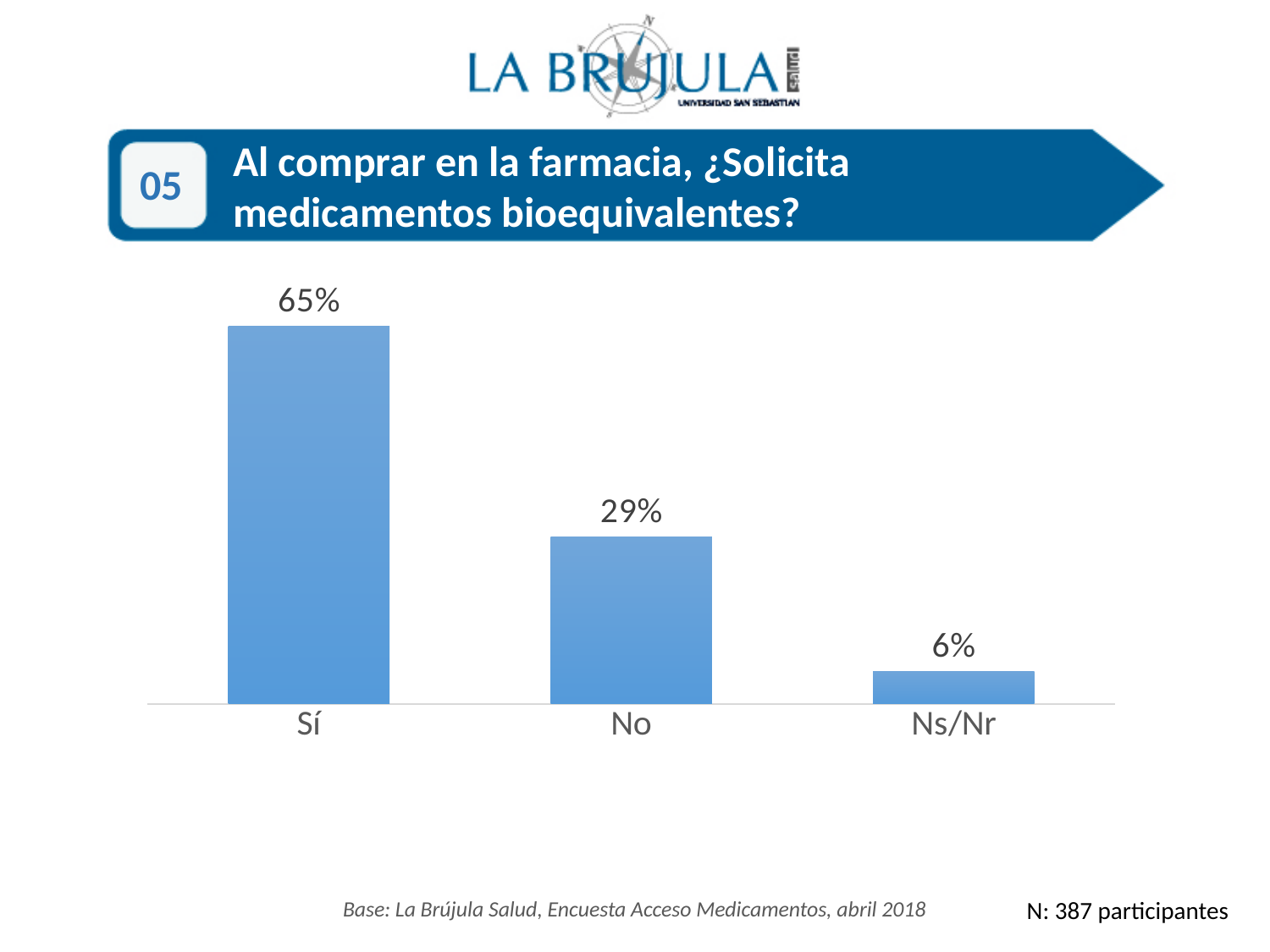
What is the value for Sí? 65% What kind of chart is shown on the slide? Bar chart What is the value for Ns/Nr? 6% Which category has the lowest value? Ns/Nr Do the values rise or fall from left to right along the x axis? Fall Which is larger, the value for No or the value for Ns/Nr? No What is the value for No? 29% What is the difference between the values for No and Ns/Nr? 23% Which category has the highest value? Sí What is the difference between the values for Sí and No? 36% What is the question shown in the title banner above the chart? Al comprar en la farmacia, ¿Solicita medicamentos bioequivalentes? How many categories are shown on the x axis? 3